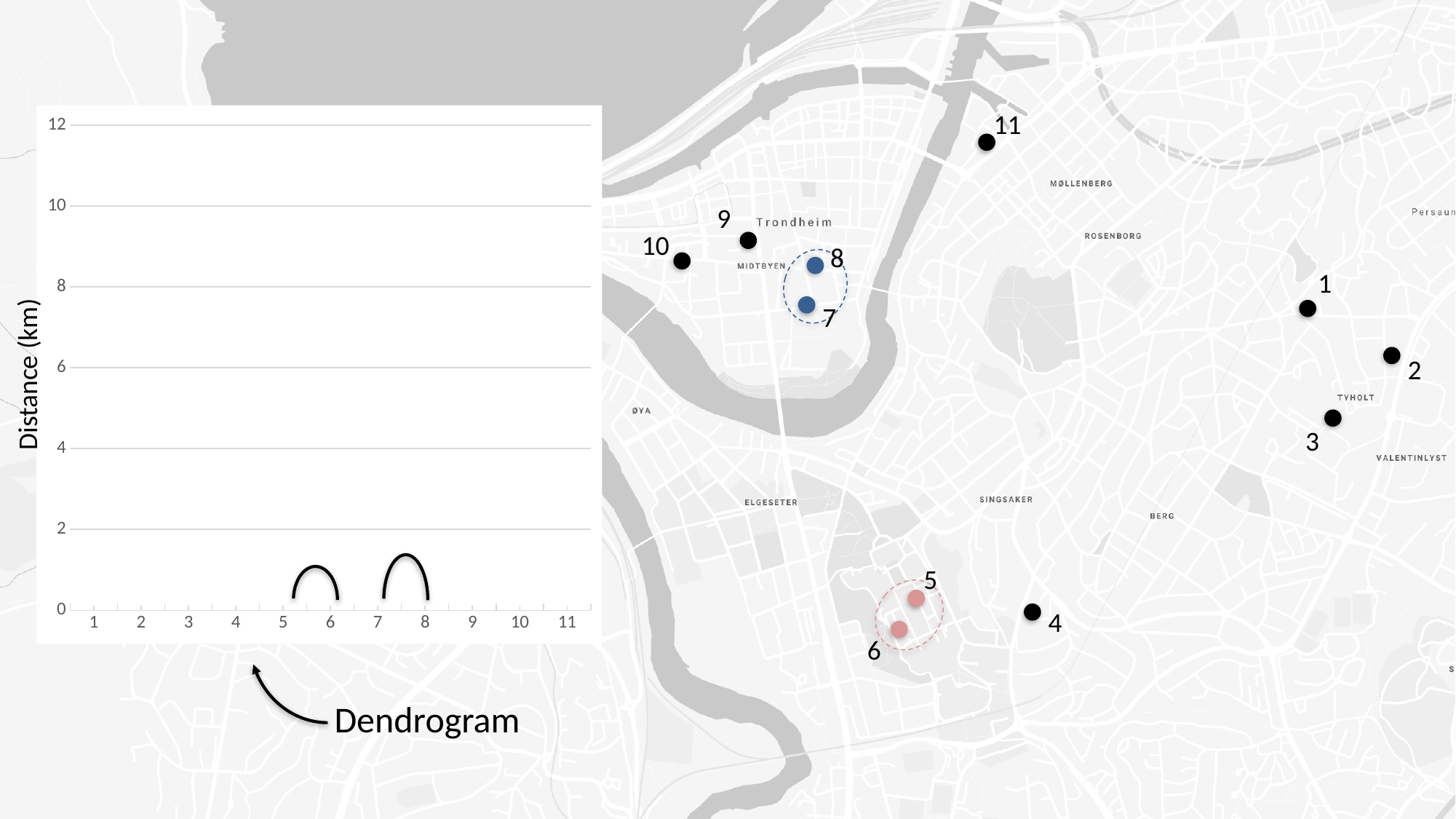
What is the label of the y axis of the dendrogram? Distance (km) What kind of chart is shown on the left of the slide? Dendrogram Which pair of points in the dendrogram is joined at the lowest distance? 5 and 6 How many numbered categories are shown along the x axis of the dendrogram? 11 Which two points does the right arc in the dendrogram join? 7 and 8 How many linking arcs are drawn in the dendrogram? 2 Is the height of the arc joining points 7 and 8 greater or less than 2 km? less Which arc in the dendrogram reaches higher, the one joining 5 and 6 or the one joining 7 and 8? 7 and 8 What is the highest tick value shown on the y axis of the dendrogram? 12 Is the height of the arc joining points 5 and 6 greater or less than 2 km? less How many numbered points are plotted on the map? 11 Which two points does the left arc in the dendrogram join? 5 and 6